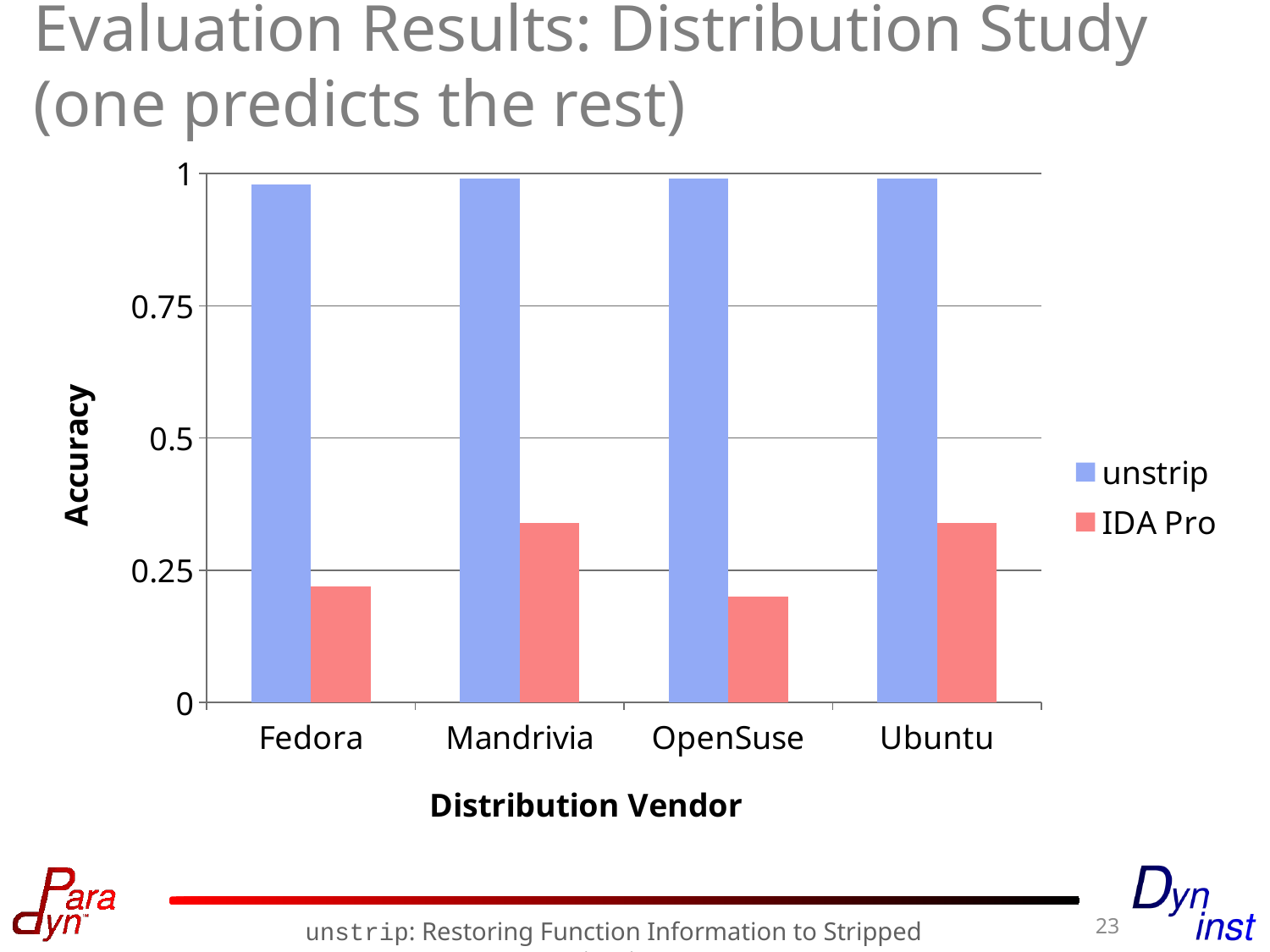
What kind of chart is shown on the slide? bar chart Is the IDA Pro accuracy for Fedora greater or less than 0.25? less Which has the higher IDA Pro accuracy, Mandrivia or Fedora? Mandrivia How many distribution vendors are shown on the x axis? 4 Is the IDA Pro accuracy for OpenSuse greater or less than 0.25? less For Ubuntu, which series has the higher accuracy, unstrip or IDA Pro? unstrip Is the IDA Pro accuracy for Ubuntu greater or less than 0.5? less Which two series are listed in the legend? unstrip and IDA Pro What is the label of the y axis? Accuracy How many series does the legend list? 2